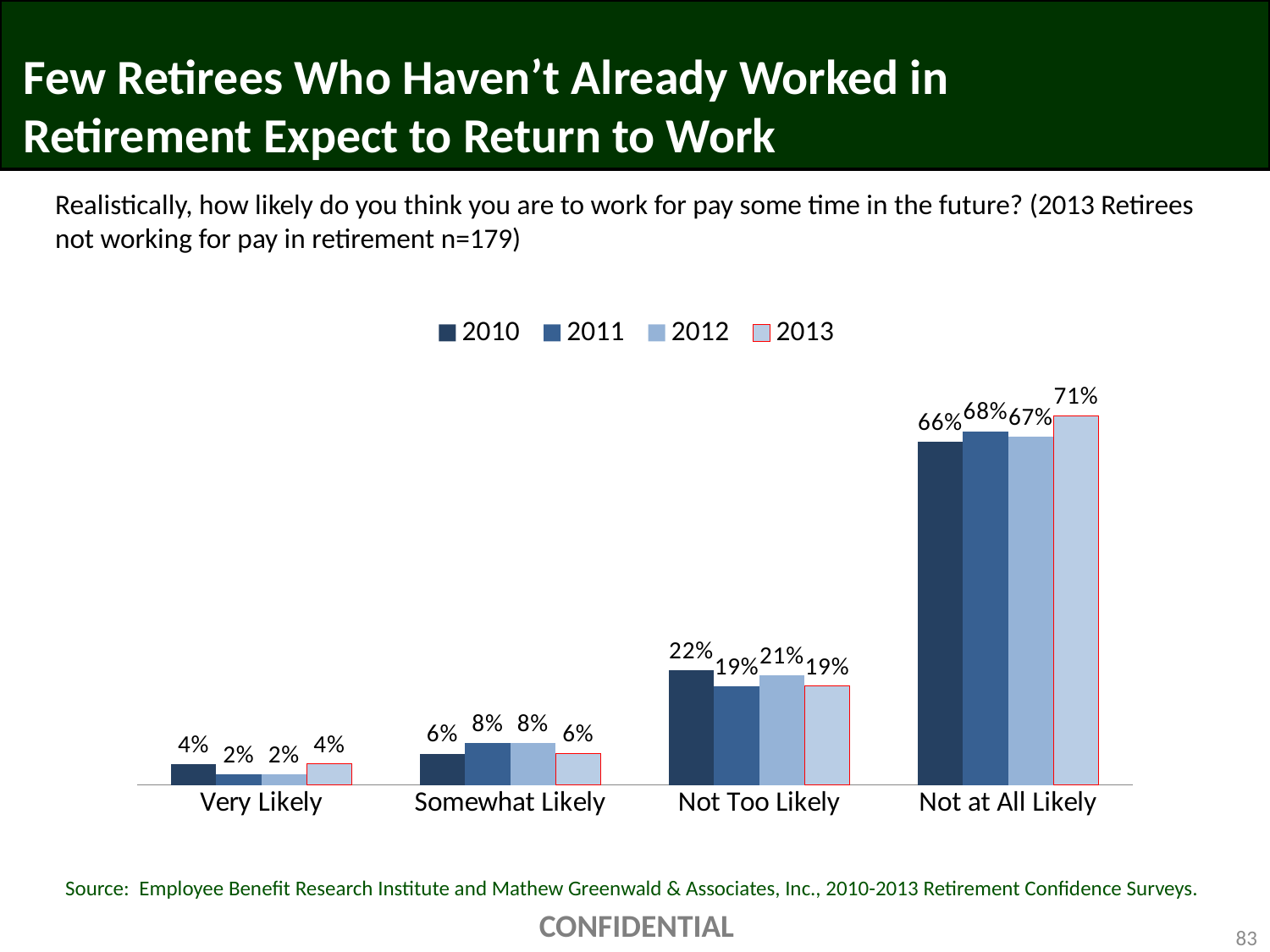
What is the value for 2011 in the Very Likely category? 2% Which is larger in the Not Too Likely category, the 2010 value or the 2011 value? 2010 How many categories are shown on the x axis? 4 What is the value for 2013 in the Not at All Likely category? 71% What is the value for 2012 in the Somewhat Likely category? 8% Which category has the highest value for 2013? Not at All Likely What is the difference between the 2013 and 2010 values in the Not at All Likely category? 5% How many series does the legend list? 4 Do the 2013 values rise or fall from Very Likely to Not at All Likely along the x axis? Rise What is the value for 2010 in the Not Too Likely category? 22% Which year has the lowest value in the Not at All Likely category? 2010 What kind of chart is shown on the slide? Bar chart